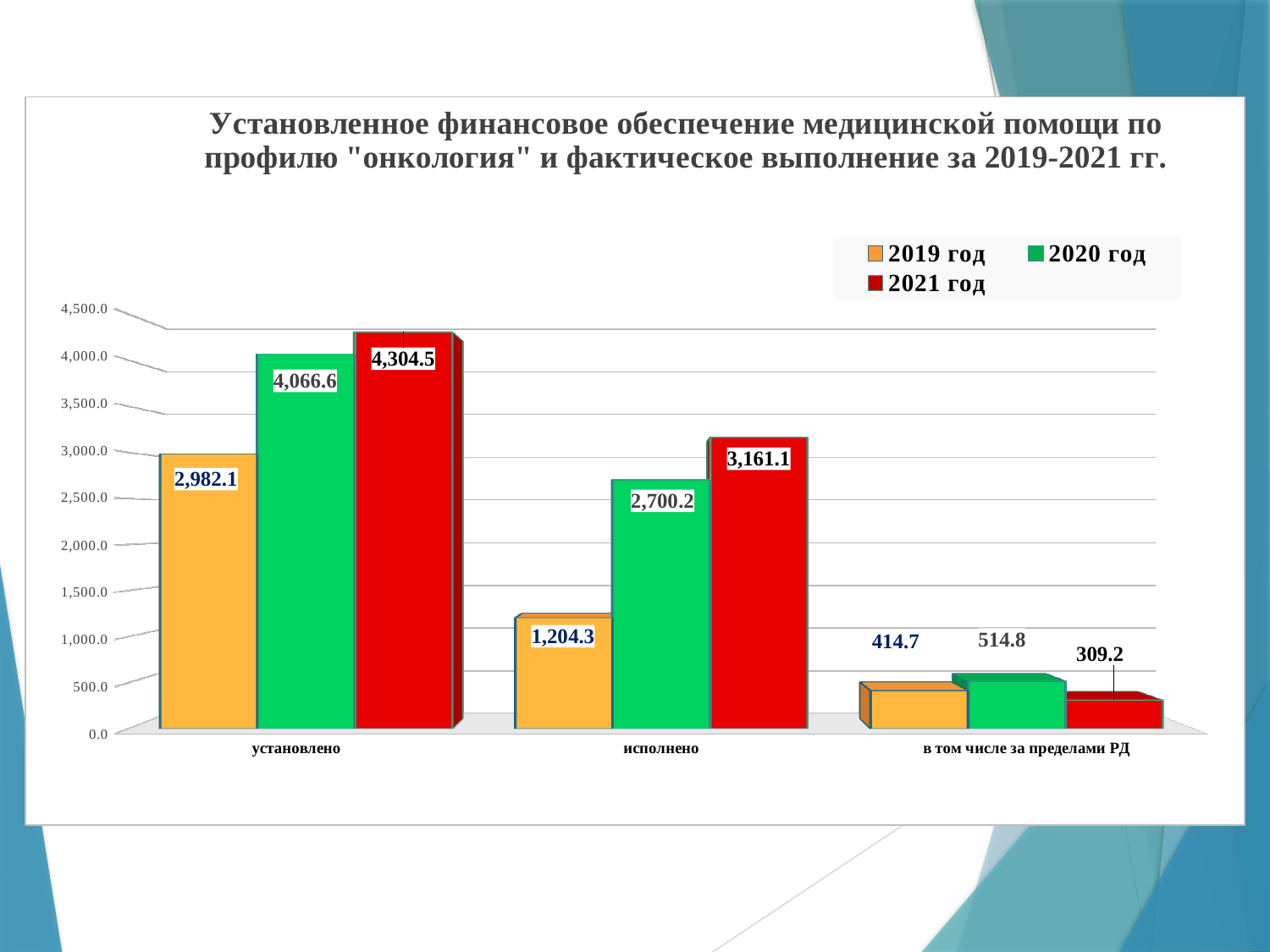
Is the 2020 год value for "исполнено" greater or less than 2,500.0? greater Which year has the lowest value in the category "в том числе за пределами РД"? 2021 год Which is larger: the 2019 год value for "установлено" or the 2021 год value for "исполнено"? 2021 год value for "исполнено" What is the value for 2020 год in the category "в том числе за пределами РД"? 514.8 Which colour represents 2021 год in the chart? Red What kind of chart is shown on the slide? Bar chart How many categories are shown on the x axis? 3 What is the difference between the 2021 год and 2020 год values in the category "исполнено"? 460.9 What is the value for 2019 год in the category "исполнено"? 1,204.3 What is the value for 2021 год in the category "установлено"? 4,304.5 How many series does the legend list? 3 Which year has the highest value in the category "установлено"? 2021 год